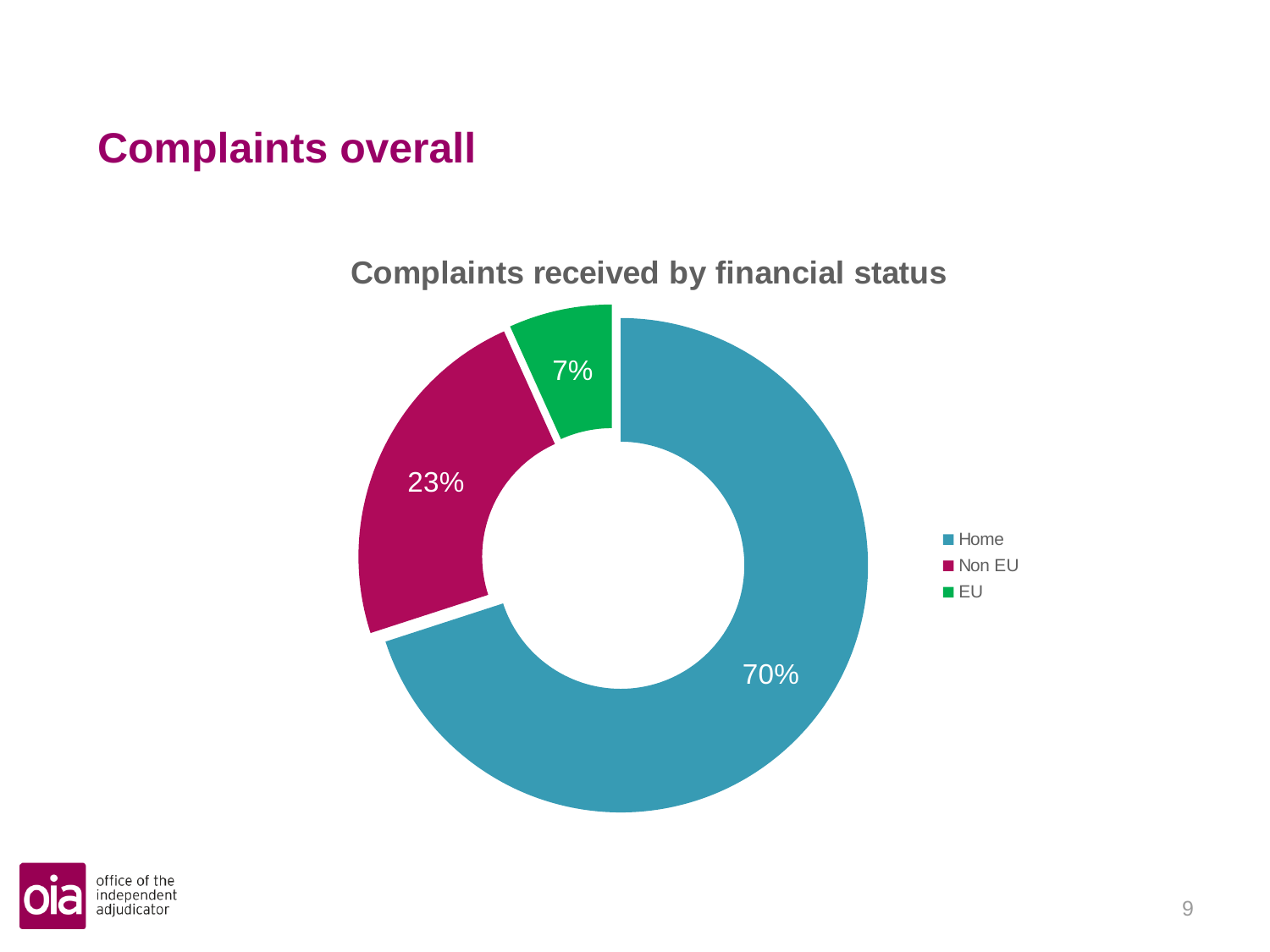
What percentage of complaints received were from EU students? 7% What is the difference in percentage points between the Non EU and EU shares? 16 What type of chart is shown on the slide? Pie chart (doughnut) What colour represents the EU category in the chart? Green Which financial status category accounts for the largest share of complaints? Home What percentage of complaints received were from Non EU students? 23% What percentage of complaints received were from Home students? 70% How many categories are shown in the chart? 3 Which is larger, the share for Non EU or the share for EU? Non EU What is the difference in percentage points between the Home and Non EU shares? 47 Which financial status category accounts for the smallest share of complaints? EU What is the title of the chart? Complaints received by financial status